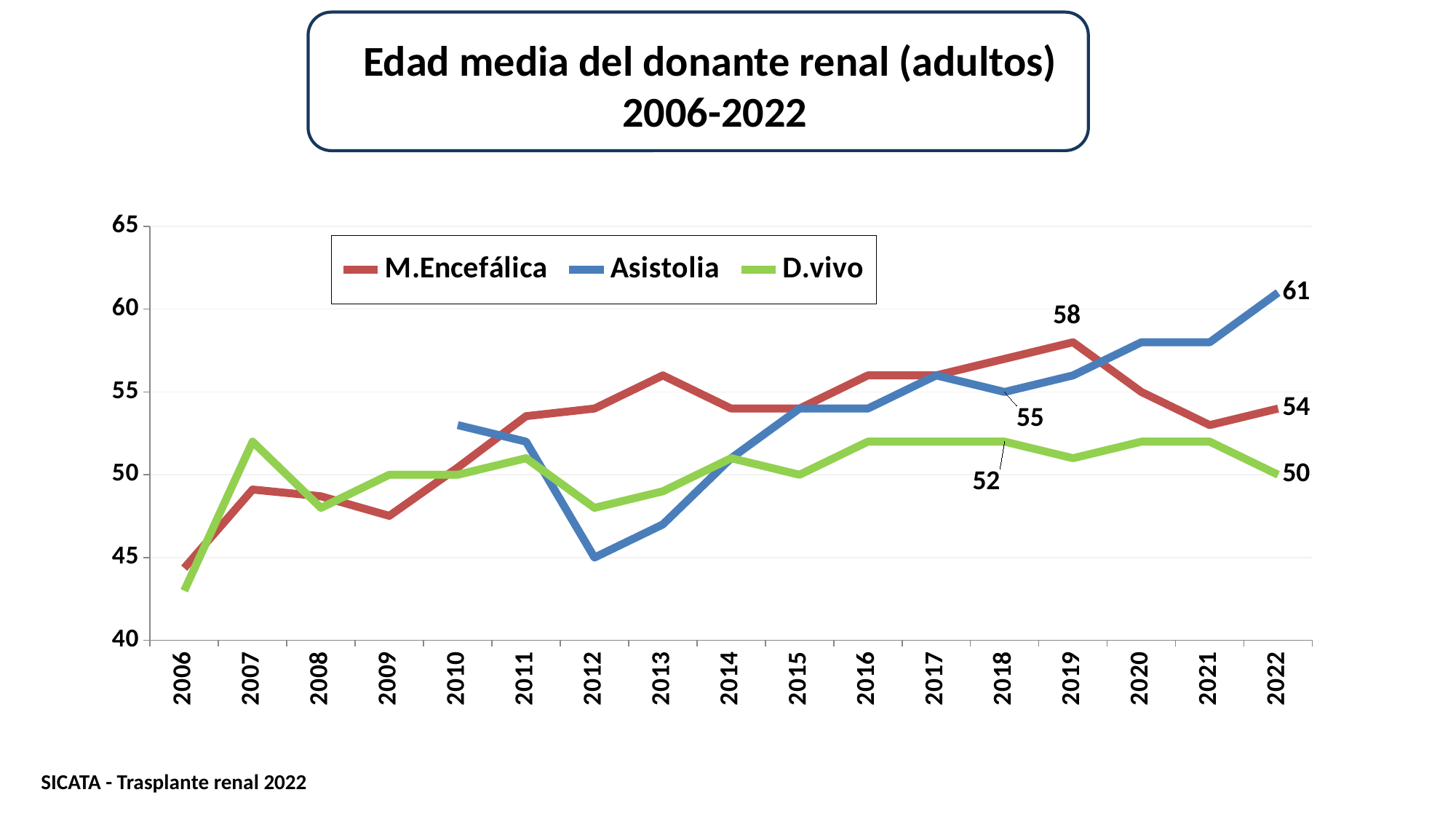
How many years are shown on the x axis? 17 How many series does the legend list? 3 What is the difference between the Asistolia and M.Encefálica values in 2022? 7 What is the value for Asistolia in 2018? 55 What is the value for M.Encefálica in 2019? 58 Which series has the higher value in 2022, Asistolia or D.vivo? Asistolia What kind of chart is shown on the slide? line chart What is the value for M.Encefálica in 2022? 54 What is the value for D.vivo in 2022? 50 Is the value for Asistolia in 2012 greater or less than 50? less Does the Asistolia line rise or fall from 2019 to 2022? rise What is the value for Asistolia in 2022? 61